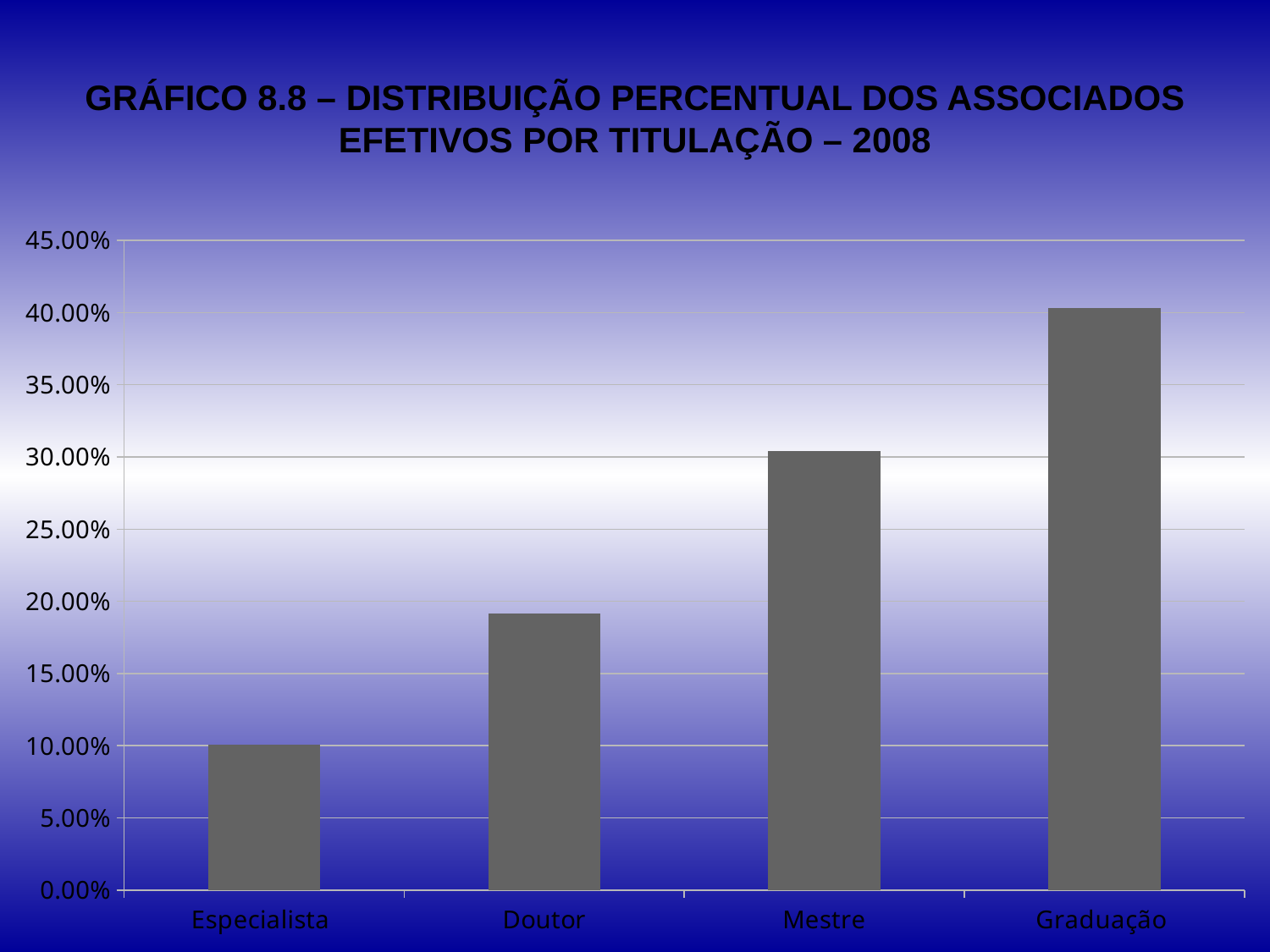
Do the values rise or fall moving from left to right along the x axis? rise What kind of chart is shown on the slide? bar chart Is the value for Doutor greater or less than 15.00%? greater Which is larger, the value for Mestre or the value for Doutor? Mestre Which category has the highest value in the chart? Graduação Is the value for Mestre greater or less than 25.00%? greater Is the value for Doutor greater or less than 20.00%? less What is the title of the chart on the slide? GRÁFICO 8.8 – DISTRIBUIÇÃO PERCENTUAL DOS ASSOCIADOS EFETIVOS POR TITULAÇÃO – 2008 Which category has the lowest value in the chart? Especialista How many categories are shown on the x axis of the chart? 4